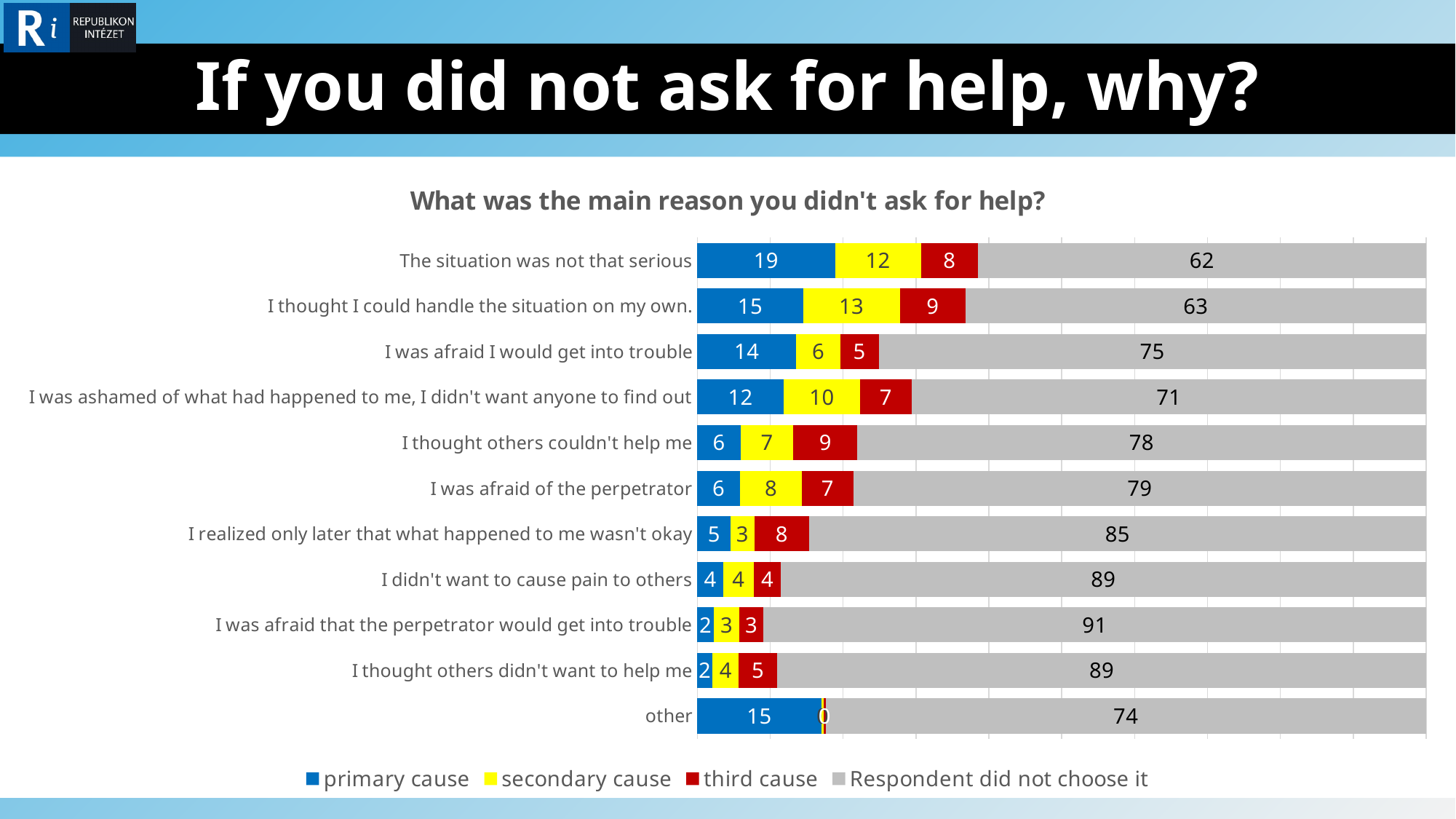
What is the third cause value for 'I thought others couldn't help me'? 9 How many series does the legend list? 4 What is the difference between the primary cause values for 'The situation was not that serious' and 'I was afraid I would get into trouble'? 5 What type of chart is shown on the slide? stacked bar chart Which category has the lowest 'Respondent did not choose it' value? The situation was not that serious What is the secondary cause value for 'I thought I could handle the situation on my own.'? 13 Which is larger: the secondary cause value for 'I was ashamed of what had happened to me, I didn't want anyone to find out' or for 'I was afraid I would get into trouble'? I was ashamed of what had happened to me, I didn't want anyone to find out What is the 'Respondent did not choose it' value for 'I was afraid of the perpetrator'? 79 How many categories (reasons) are plotted in the chart? 11 What is the primary cause value for 'The situation was not that serious'? 19 Which category has the highest 'Respondent did not choose it' value? I was afraid that the perpetrator would get into trouble Which category has the highest primary cause value? The situation was not that serious